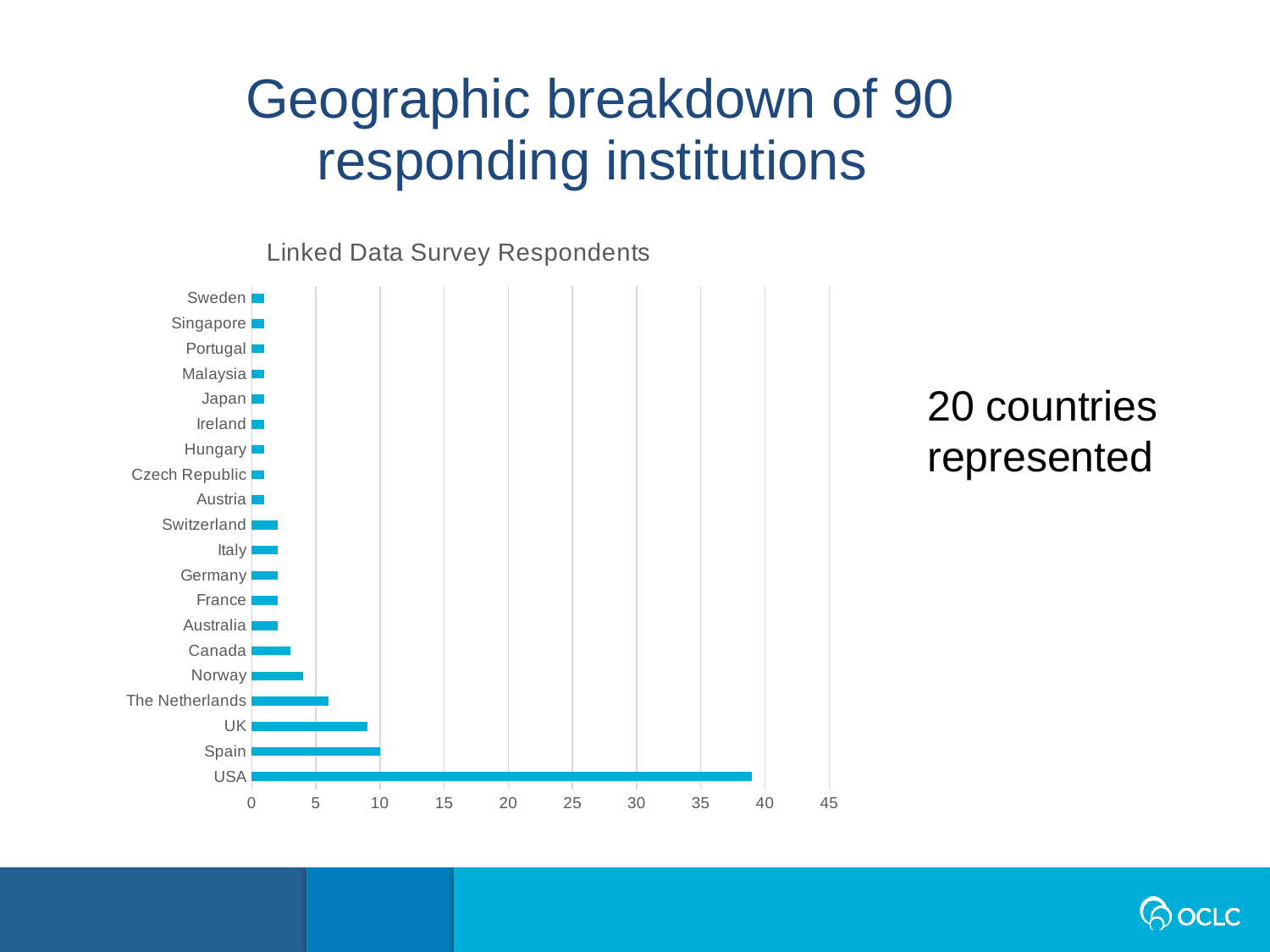
Is the value for Norway greater or less than 5? less How many countries are listed on the chart? 20 Which has more respondents, Spain or The Netherlands? Spain Is the value for UK greater or less than 10? less Is the value for The Netherlands greater or less than 5? greater What type of chart is shown on the slide? bar chart Which has more respondents, Norway or Canada? Norway What is the title of the chart? Linked Data Survey Respondents Which country has the highest number of respondents? USA Which has more respondents, UK or The Netherlands? UK